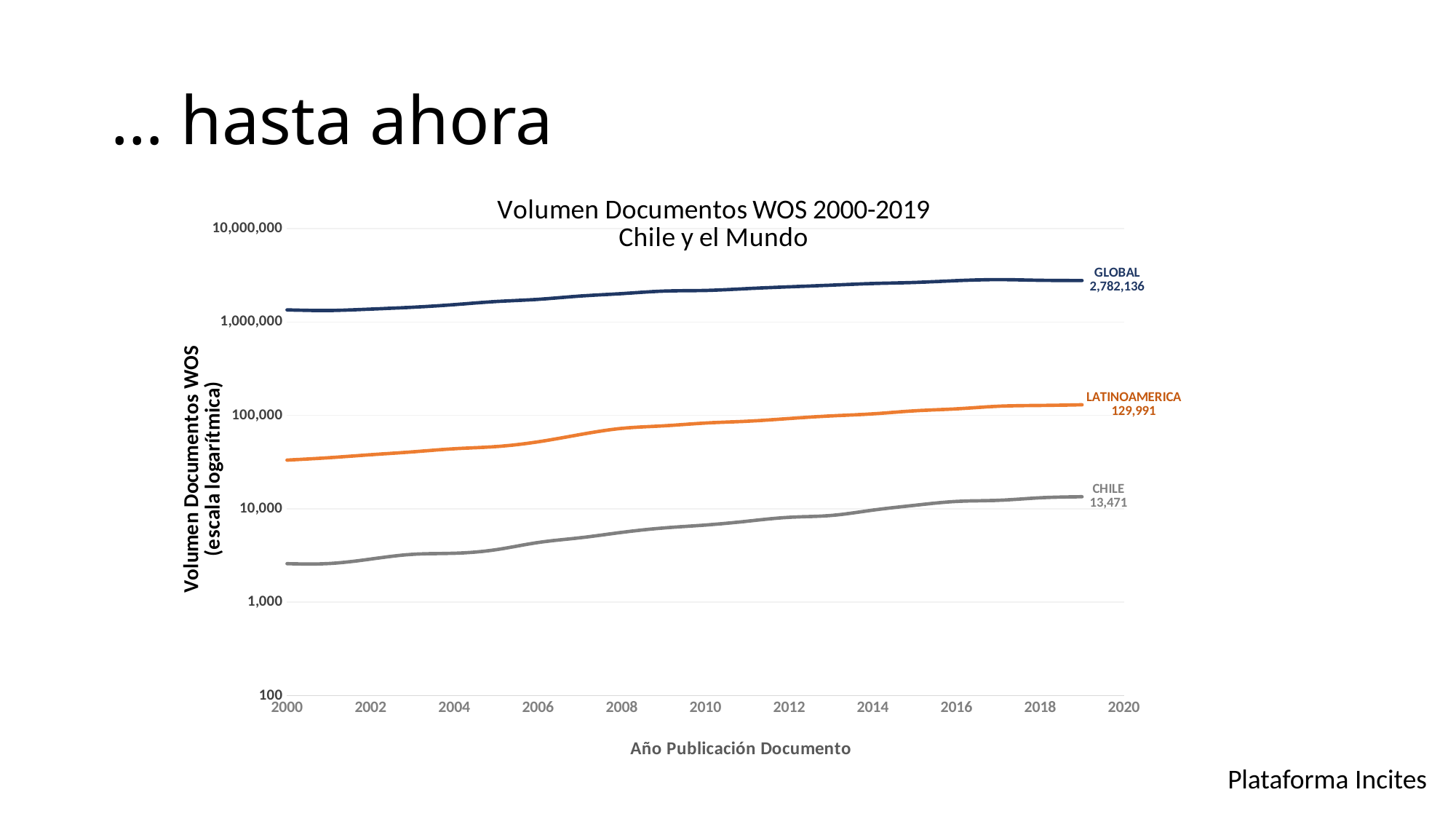
What kind of chart is shown on the slide? Line chart What is the final labelled value for the LATINOAMERICA series? 129,991 How many series are plotted on the chart? 3 What is the final labelled value for the CHILE series? 13,471 Which series has the highest values across the chart? GLOBAL What is the title of the chart? Volumen Documentos WOS 2000-2019 Chile y el Mundo Does the CHILE series rise or fall from 2000 to 2019? Rise What is the difference between the final labelled values of LATINOAMERICA and CHILE? 116,520 What is the final labelled value for the GLOBAL series? 2,782,136 Is the value for CHILE in 2000 greater or less than 10,000? less Is the value for GLOBAL in 2000 greater or less than 1,000,000? greater Which series has the lowest values across the chart? CHILE